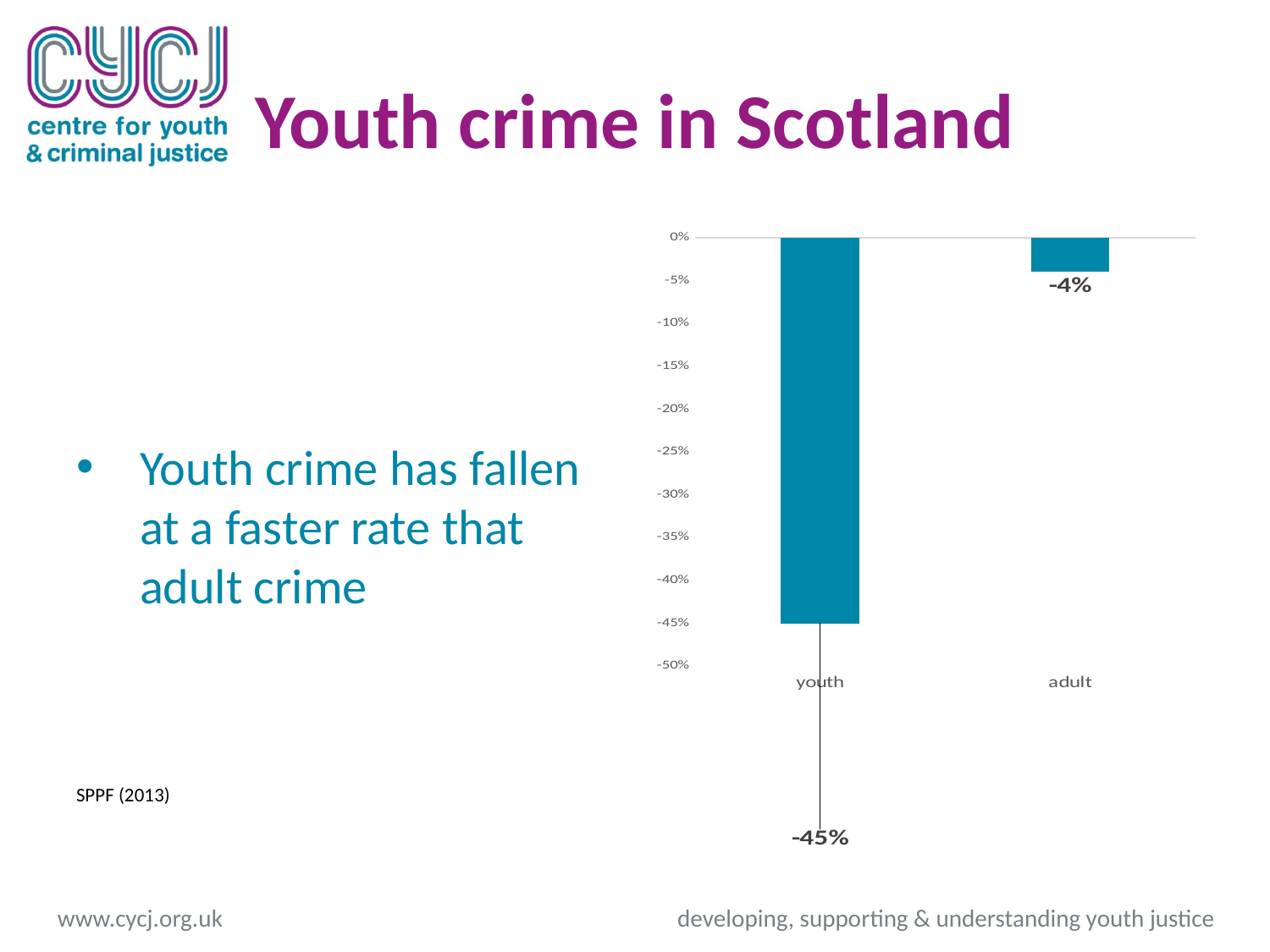
Which category has the larger decrease, youth or adult? youth What is the difference between the youth and adult values? 41 percentage points What is the lowest value shown on the vertical axis? -50% Is the value for youth greater or less than -40%? less What is the value for adult? -4% Is the value for adult greater or less than -10%? greater Which category has the value closest to 0%? adult What kind of chart is shown on the slide? bar chart Which category shows the largest fall? youth How many categories are shown on the chart? 2 What colour are the bars in the chart? teal blue What is the value for youth? -45%